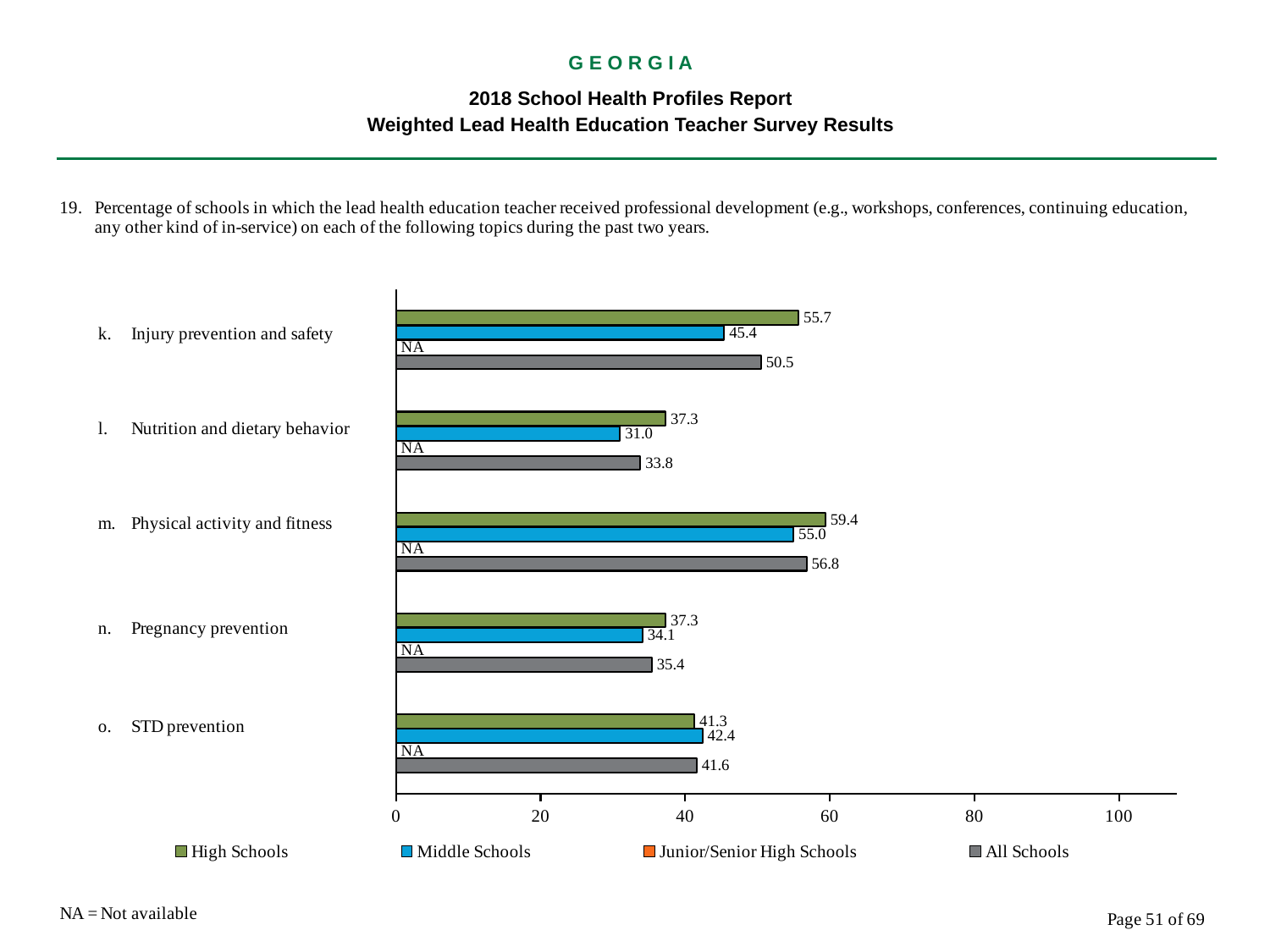
How many series does the legend list? 4 What kind of chart is shown on the slide? Bar chart What is the All Schools value for STD prevention? 41.6 What is the Middle Schools value for Nutrition and dietary behavior? 31.0 What does NA stand for according to the note on the slide? Not available What is the High Schools value for Physical activity and fitness? 59.4 For STD prevention, which is larger: the High Schools value or the Middle Schools value? Middle Schools Which topic has the highest All Schools value? Physical activity and fitness What is the Junior/Senior High Schools value for Pregnancy prevention? NA How many topics are shown on the chart? 5 What is the difference between the High Schools and Middle Schools values for Injury prevention and safety? 10.3